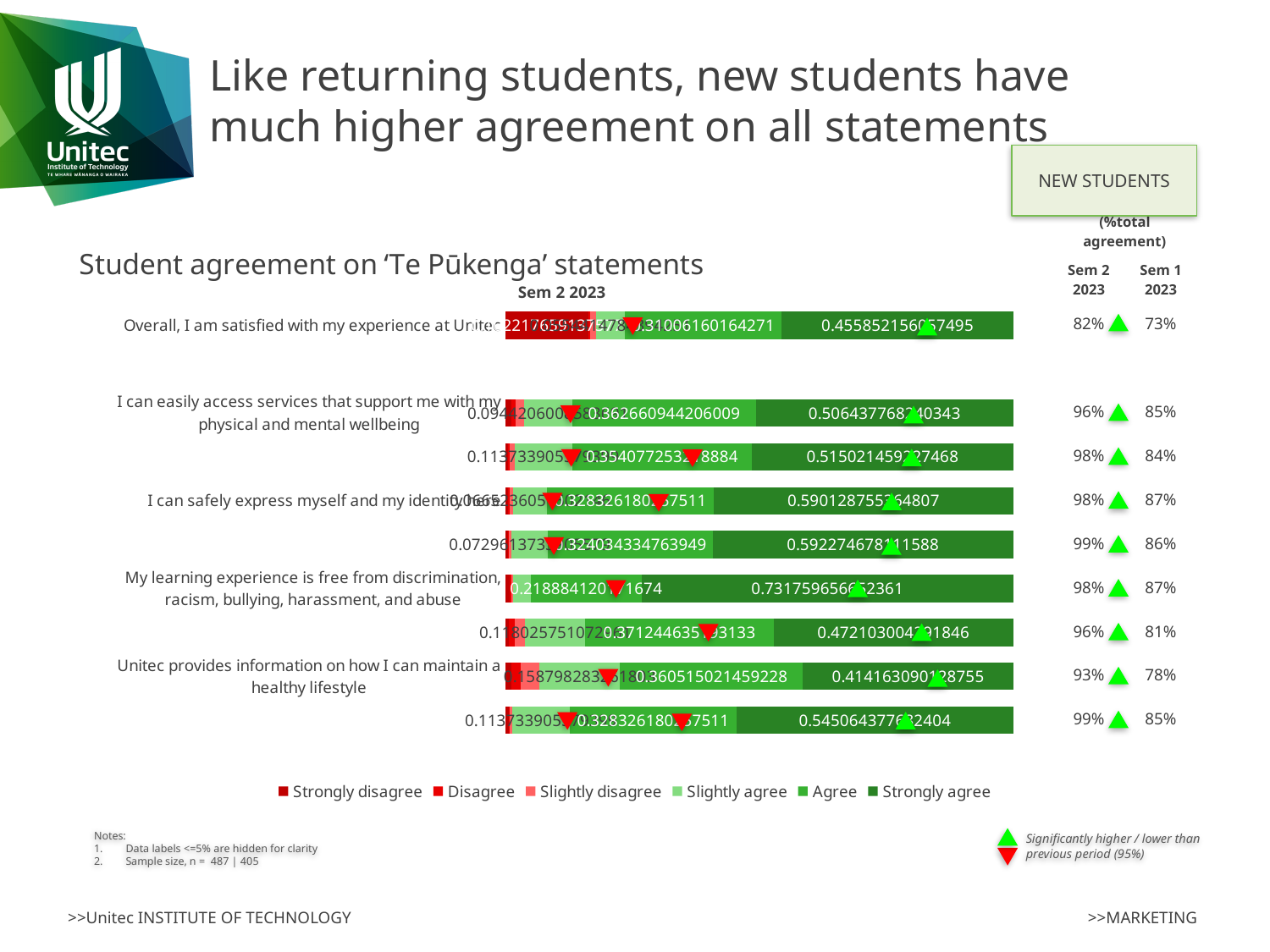
Which statement has the largest Strongly agree segment in the chart? My learning experience is free from discrimination, racism, bullying, harassment, and abuse How many bars are plotted in the chart? 9 In the table beside the chart, what is the difference between Sem 2 2023 and Sem 1 2023 total agreement for 'Overall, I am satisfied with my experience at Unitec'? 9% In the table beside the chart, what is the Sem 2 2023 total agreement for 'Overall, I am satisfied with my experience at Unitec'? 82% What is the Agree data label on the bar for 'Unitec provides information on how I can maintain a healthy lifestyle'? 0.360515021459228 In the bar for 'My learning experience is free from discrimination, racism, bullying, harassment, and abuse', which is larger: the Agree segment or the Strongly agree segment? Strongly agree Which legend entry is listed first in the chart legend? Strongly disagree What kind of chart is shown on the slide? Stacked bar chart How many series does the chart legend list? 6 What is the Agree data label on the bar for 'I can easily access services that support me with my physical and mental wellbeing'? 0.362660944206009 In the table beside the chart, what is the Sem 1 2023 total agreement for 'Unitec provides information on how I can maintain a healthy lifestyle'? 78% What is the title of the chart? Student agreement on ‘Te Pūkenga’ statements